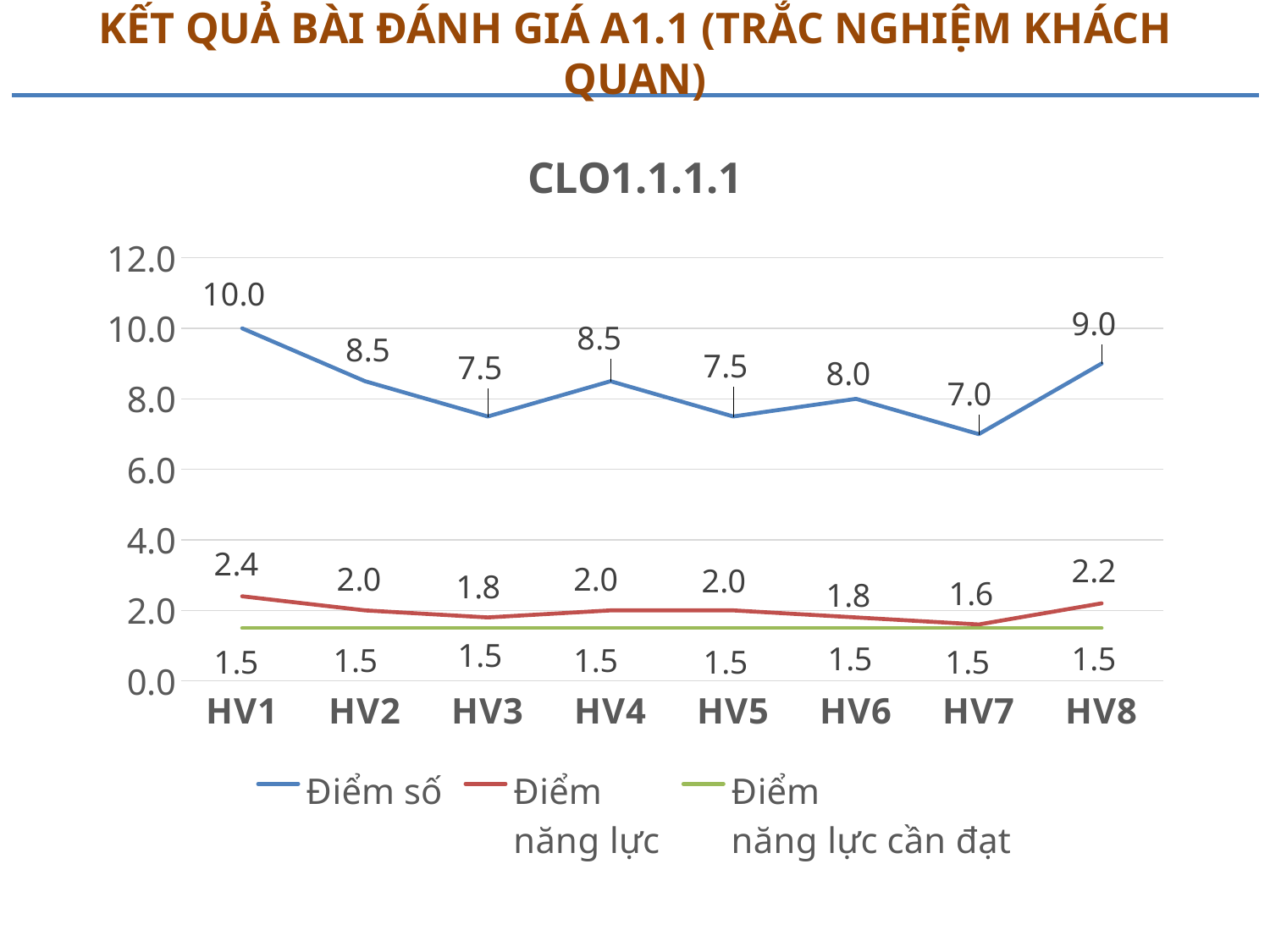
Which category has the lowest Điểm số value? HV7 Which category has the highest Điểm năng lực value? HV1 What is the title of the chart? CLO1.1.1.1 What is the Điểm số value for HV1? 10.0 What kind of chart is shown on the slide? line chart Which is larger, the Điểm số value for HV2 or for HV8? HV8 How many series does the legend list? 3 What is the Điểm năng lực value for HV8? 2.2 Is the Điểm số value for HV4 greater or less than 8.0? greater What is the Điểm năng lực cần đạt value for HV4? 1.5 What is the difference between the Điểm số values for HV1 and HV7? 3.0 How many categories are shown on the x axis? 8